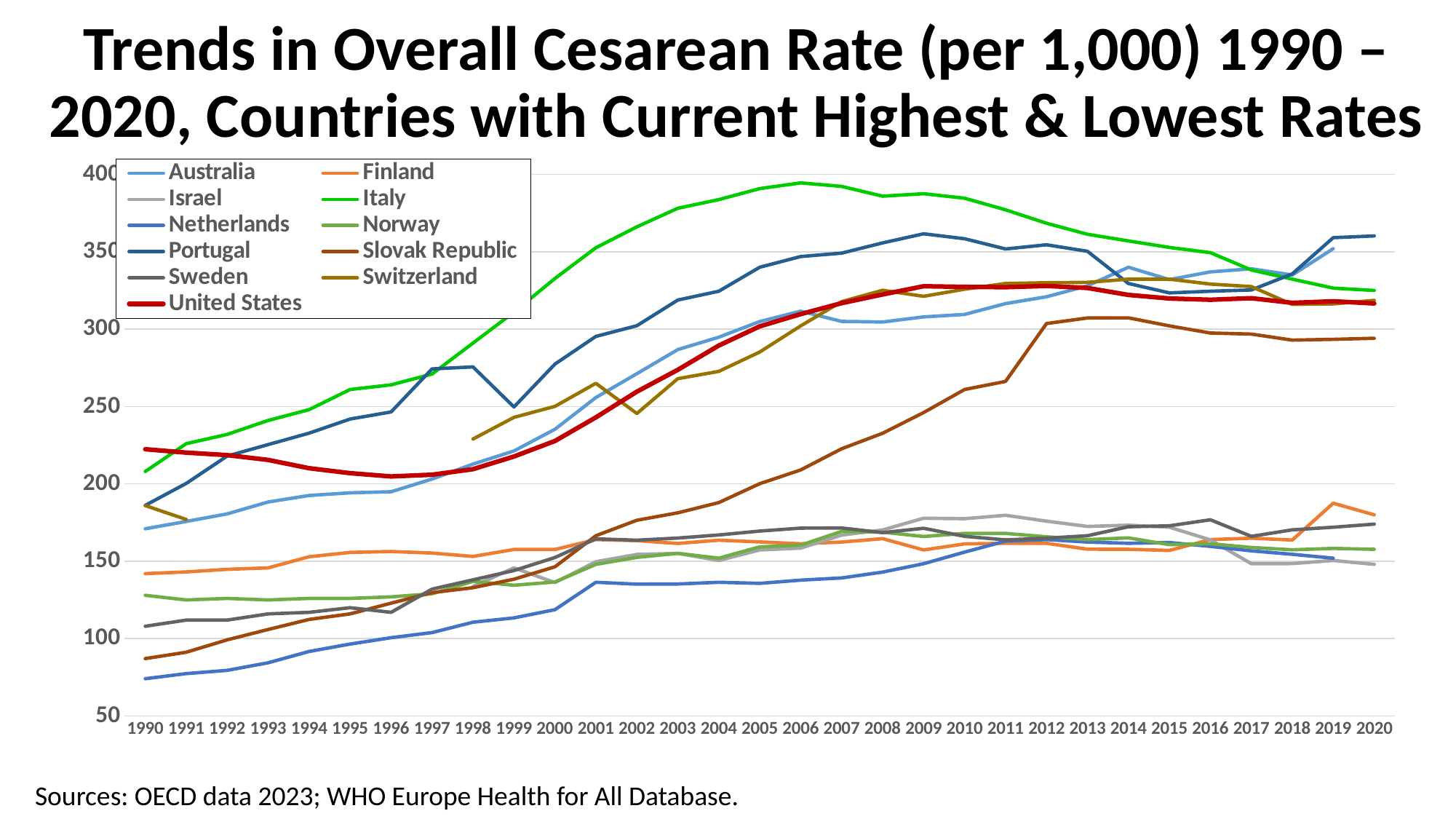
Which country has the highest cesarean rate in 2006? Italy What kind of chart is shown on the slide? Line chart Is the value for the United States in 2020 greater or less than 300? greater Does the value for Italy rise or fall from 2006 to 2020? fall In 2000, which is larger, the value for Italy or the value for the United States? Italy How many series does the legend list? 11 Which country has the lowest cesarean rate in 1990? Netherlands What colour is the United States line in the legend? Red How many years are shown along the x axis? 31 Is the value for the Netherlands in 1990 greater or less than 100? less Is the value for Italy in 2006 greater or less than 350? greater